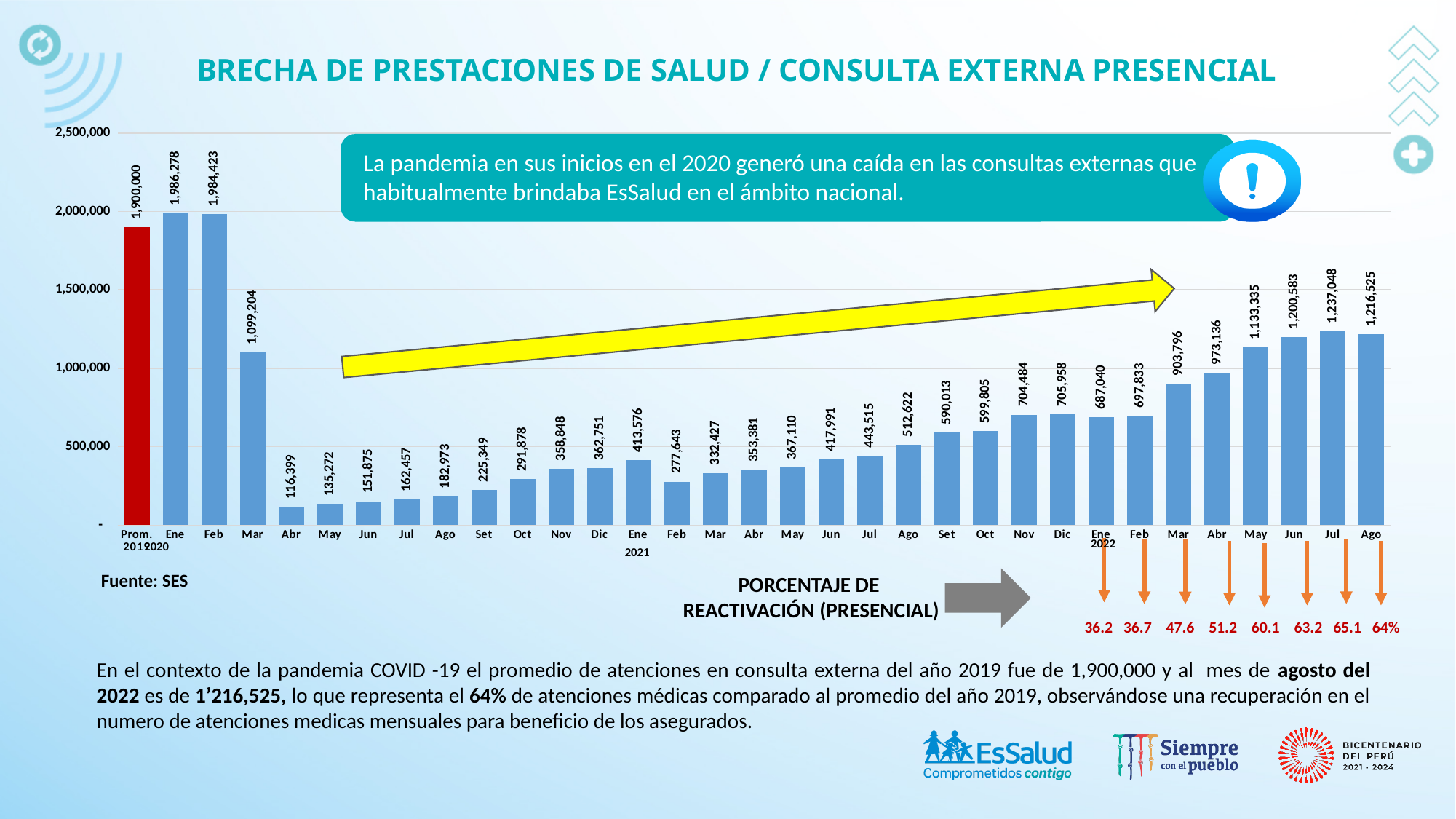
Which is larger, the value for Dic 2021 or the value for Ene 2022? Dic 2021 Do the values rise or fall from Mar 2022 to Jul 2022? rise What is the value of the Prom. 2019 bar? 1,900,000 Is the value for Mar 2022 greater or less than 500,000? greater What kind of chart is shown on the slide? bar chart What colour is the Prom. 2019 bar? red What is the value for Ago 2022 in the chart? 1,216,525 What is the difference between the Jul 2022 and Ago 2022 values? 20,523 What is the value for Mar 2020? 1,099,204 What is the value for Abr 2020? 116,399 Which month has the lowest value in the chart? Abr 2020 What is the difference between the Prom. 2019 value and the Ago 2022 value? 683,475